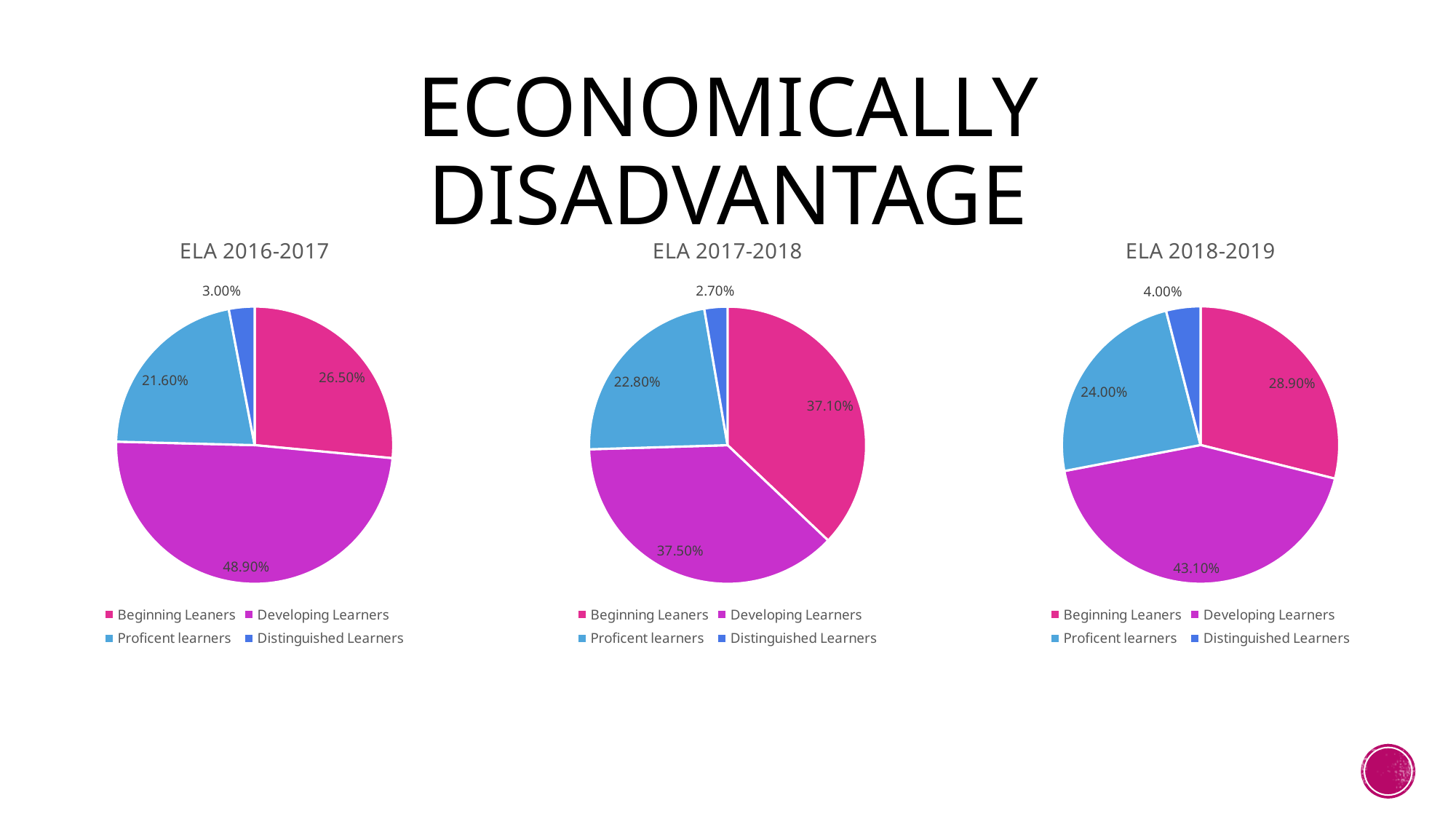
How many charts are shown on the slide? 3 What kind of chart is the ELA 2016-2017 chart? Pie chart In the ELA 2016-2017 chart, which category has the smallest slice? Distinguished Learners How many entries does the legend of the ELA 2018-2019 chart list? 4 In the ELA 2016-2017 chart, which is larger, Beginning Leaners or Proficent learners? Beginning Leaners In the ELA 2018-2019 chart, which category has the largest slice? Developing Learners How many slices does the ELA 2017-2018 pie chart have? 4 In the ELA 2017-2018 chart, what is the value for Proficent learners? 22.80% In the ELA 2018-2019 chart, what is the value for Distinguished Learners? 4.00% In the ELA 2017-2018 chart, what is the difference between Beginning Leaners and Proficent learners? 14.30% In the ELA 2017-2018 chart, what is the difference between Developing Learners and Beginning Leaners? 0.40% In the ELA 2016-2017 chart, what is the value for Developing Learners? 48.90%